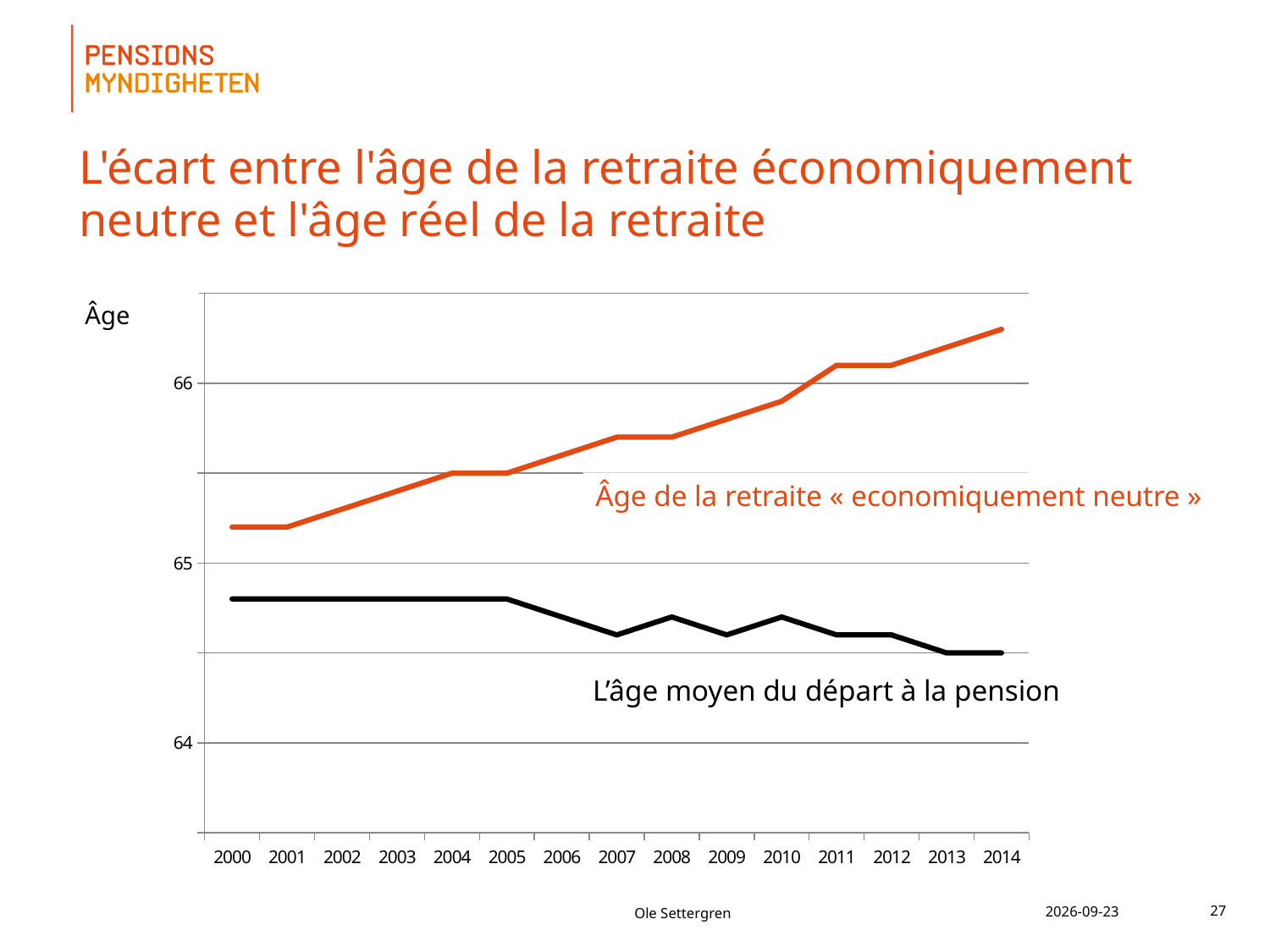
Does the 'L'âge moyen du départ à la pension' line rise or fall from 2000 to 2014? fall Is the 'Âge de la retraite « economiquement neutre »' value for 2000 greater or less than 65? greater Is the 'Âge de la retraite « economiquement neutre »' value for 2014 greater or less than 66? greater What label is shown on the y axis of the chart? Âge How many data series are plotted in the chart? 2 Is the 'L'âge moyen du départ à la pension' value for 2008 greater or less than 64? greater In 2014, which series has the larger value: 'Âge de la retraite « economiquement neutre »' or 'L'âge moyen du départ à la pension'? Âge de la retraite « economiquement neutre » Does the 'Âge de la retraite « economiquement neutre »' line rise or fall from 2000 to 2014? rise How many years are plotted along the x axis? 15 In which year is the 'Âge de la retraite « economiquement neutre »' value highest? 2014 What kind of chart is shown on the slide? line chart